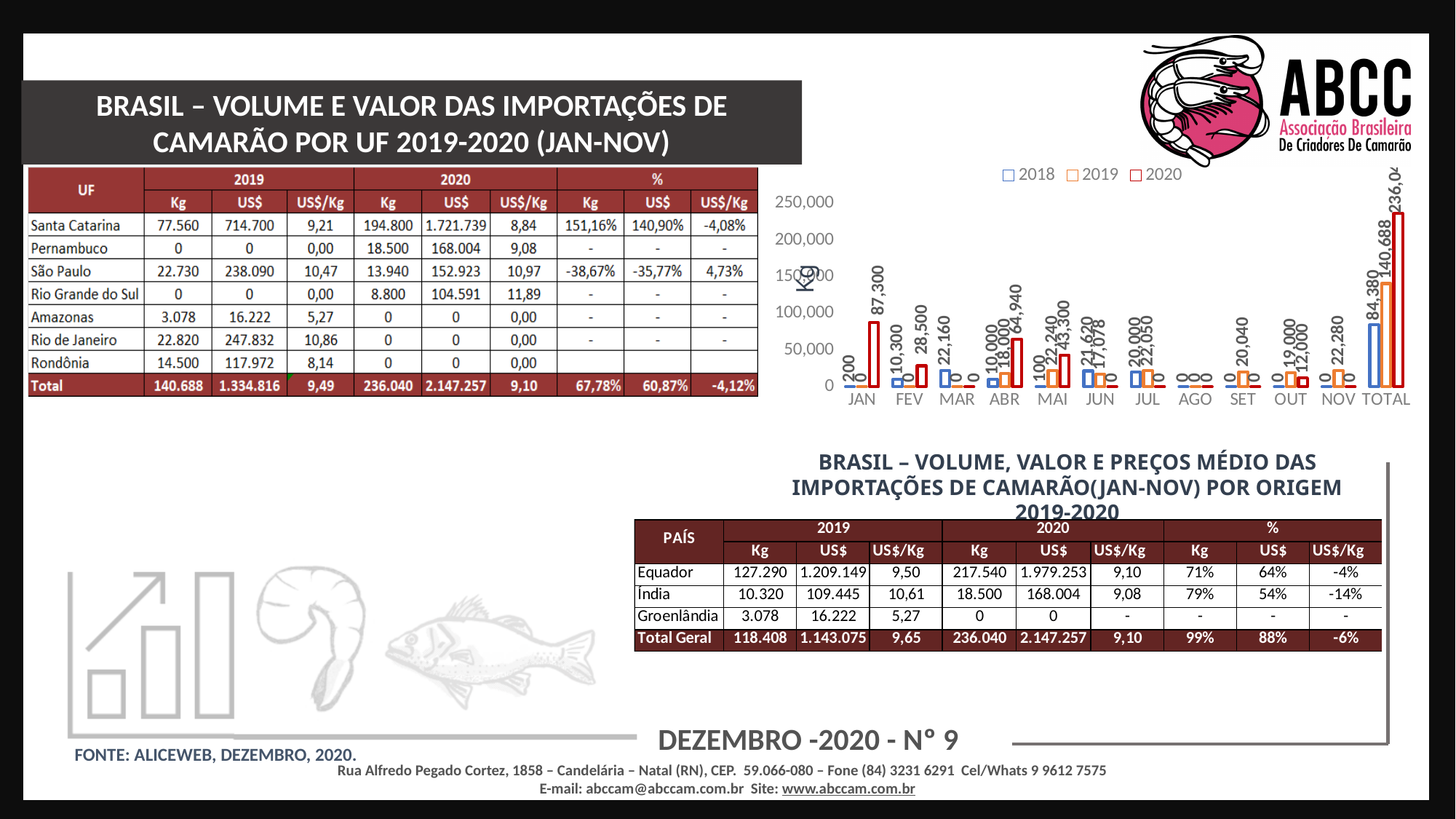
Which years are listed in the chart legend? 2018, 2019, 2020 What is the value for 2018 in the TOTAL category? 84,380 Among the months JAN to NOV, which month has the highest value for 2020? JAN What is the value for 2019 in the TOTAL category? 140,688 What is the value for 2019 in NOV? 22,280 Is the 2020 value in the TOTAL category greater or less than 200,000? greater Which is larger for 2020: ABR or MAI? ABR What kind of chart is shown on the slide? bar chart What is the value for 2020 in ABR? 64,940 What is the value for 2020 in JAN? 87,300 What is the difference between the 2020 values for JAN and FEV? 58,800 How many series does the chart legend list? 3